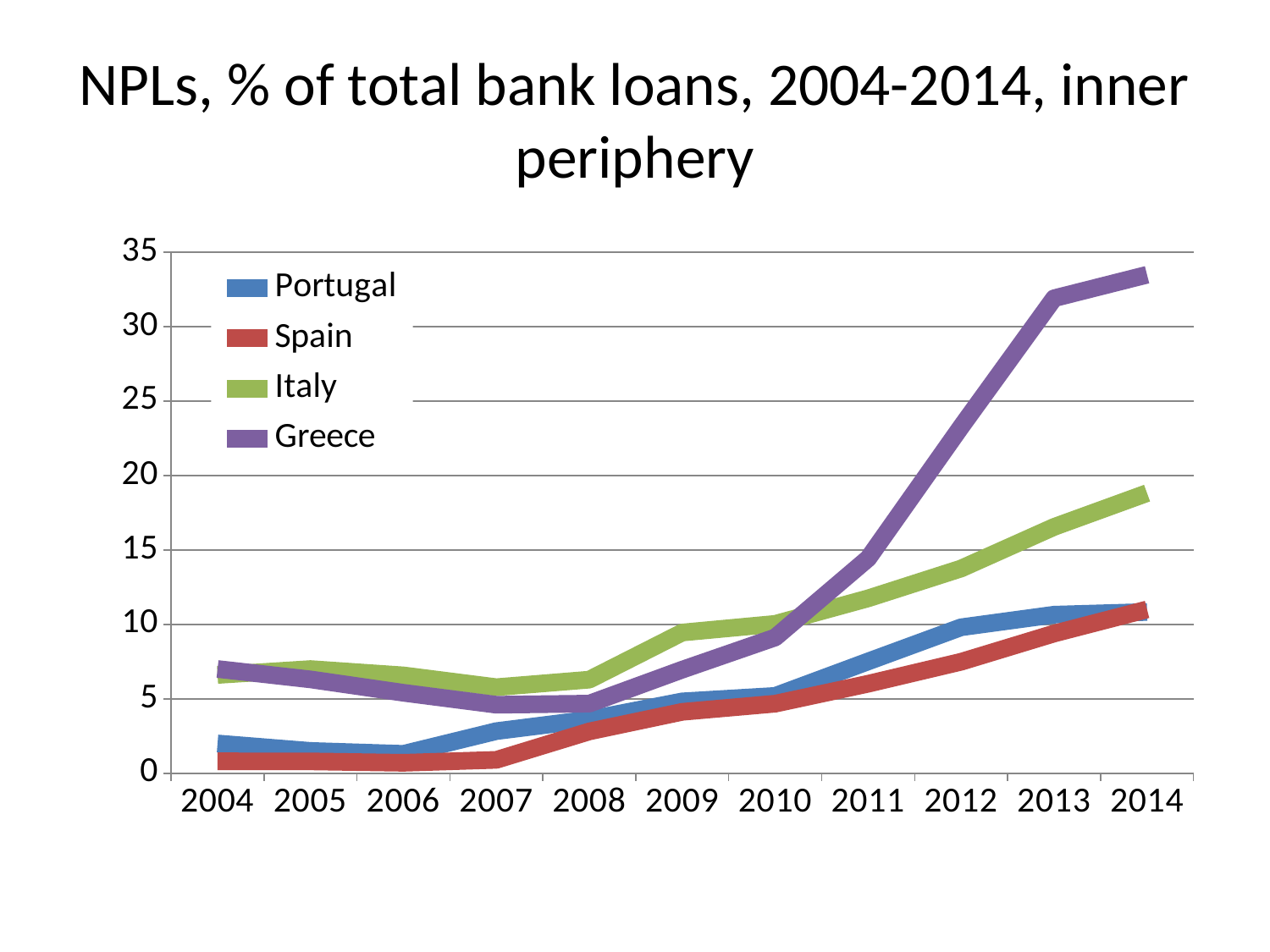
How many series does the legend list? 4 What kind of chart is shown on the slide? line chart Is the value for Spain in 2007 greater or less than 5? less Which is larger in 2009, the value for Italy or the value for Greece? Italy Which colour is used for the Italy line? green What is the title of the chart? NPLs, % of total bank loans, 2004-2014, inner periphery Is the value for Greece in 2013 greater or less than 30? greater Does the Greece line rise or fall between 2010 and 2014? rise Which country has the lowest NPL ratio in 2006? Spain How many years are shown on the x axis? 11 Is the value for Italy in 2014 greater or less than 20? less Which country has the highest NPL ratio in 2014? Greece